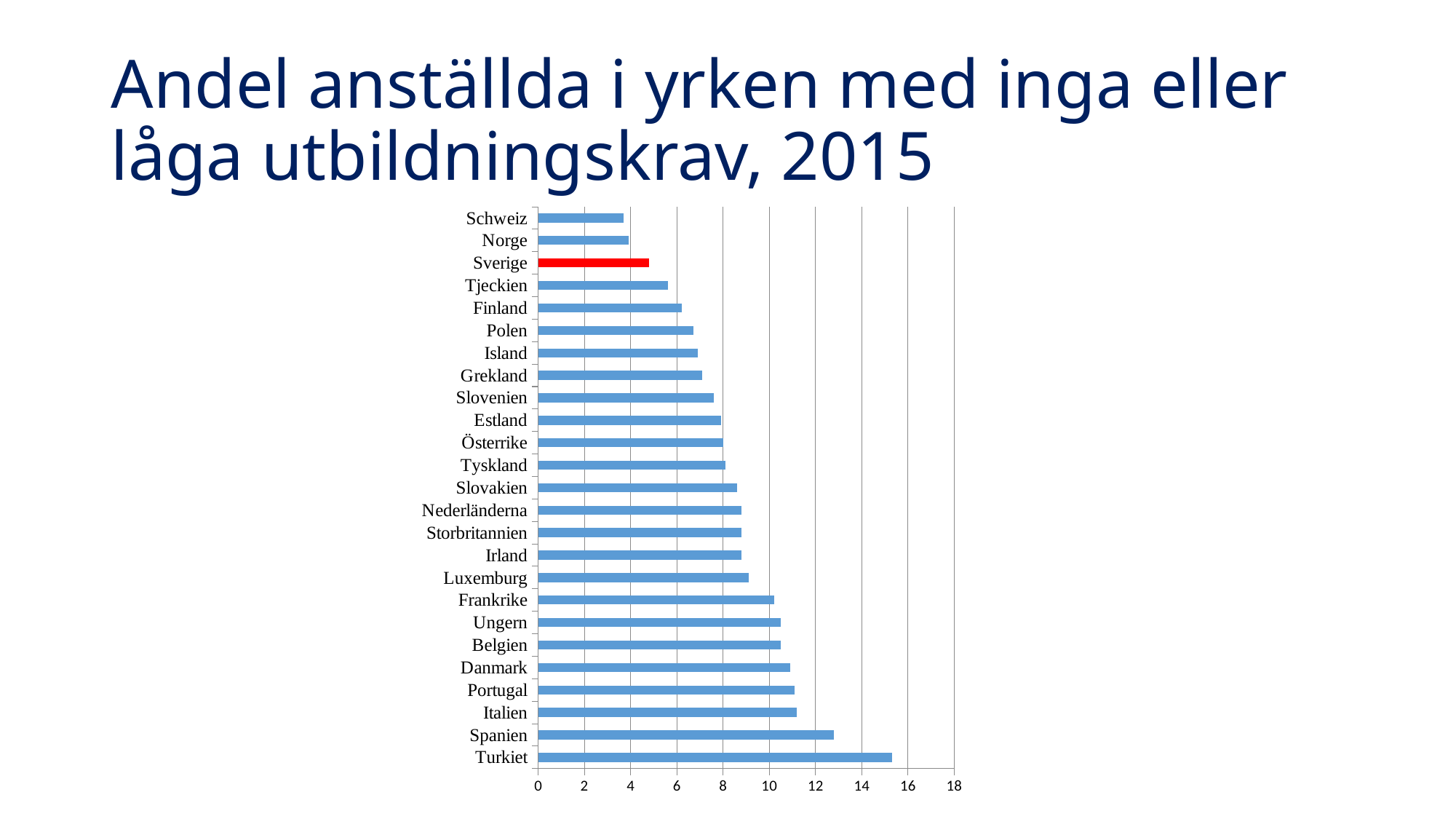
Is the value for Spanien greater or less than 12? greater Is the value for Italien greater or less than 12? less What kind of chart is shown on the slide? bar chart How many countries are shown in the chart? 25 Which has the larger value, Danmark or Finland? Danmark Is the value for Sverige greater or less than 6? less Which has the larger value, Sverige or Norge? Sverige Which country's bar is coloured red in the chart? Sverige Which country has the highest value in the chart? Turkiet